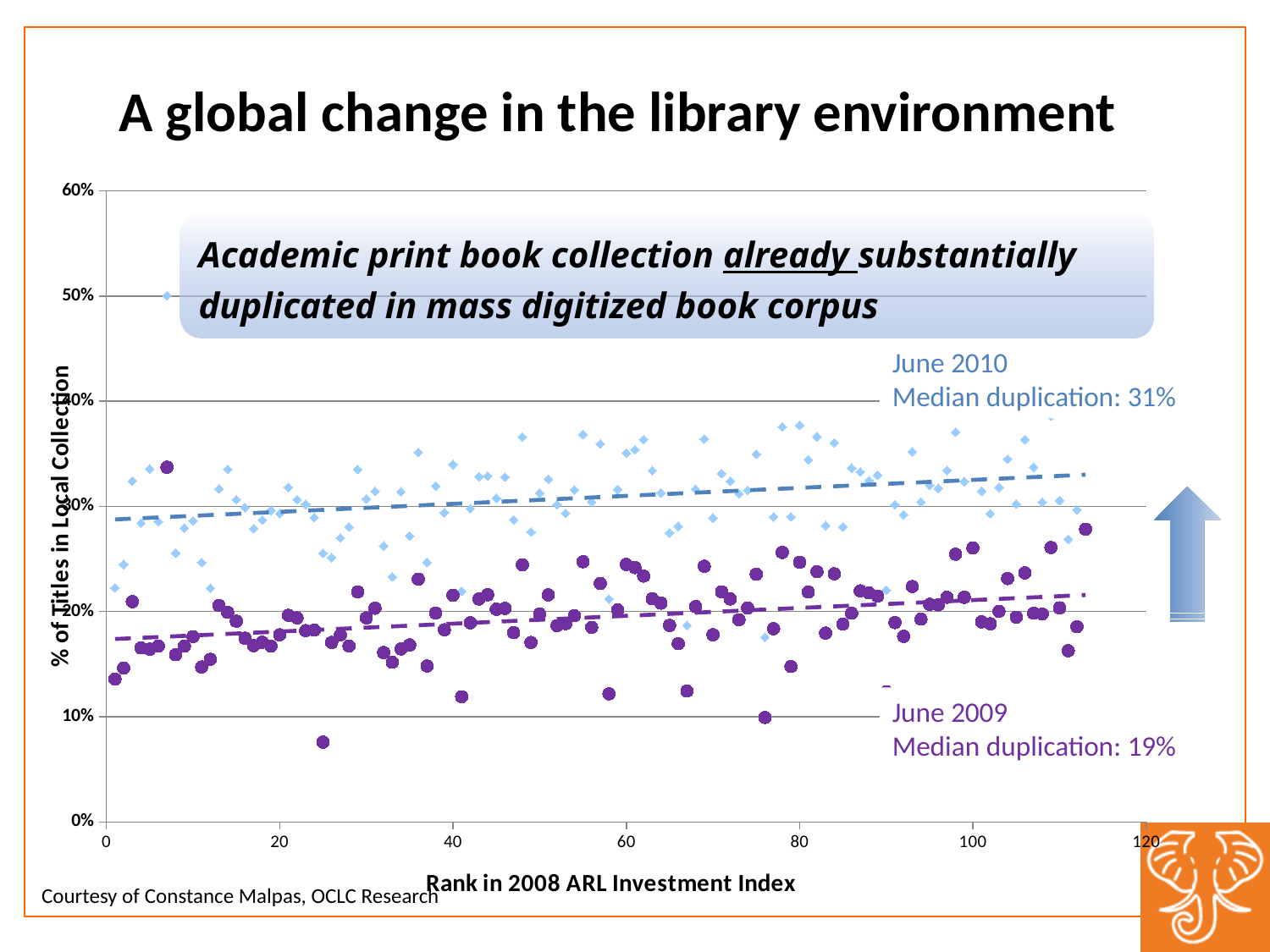
What is the difference between the June 2010 and June 2009 median duplication values? 12% What is the median duplication for June 2010 according to the chart annotation? 31% Do the dashed trend lines for both series rise or fall as rank increases along the x axis? Rise Which series has the higher median duplication, June 2010 or June 2009? June 2010 Is the highest June 2010 (blue) point greater or less than 40%? greater What is the median duplication for June 2009 according to the chart annotation? 19% Is the lowest June 2009 (purple) point greater or less than 10%? less Is the June 2009 median duplication greater or less than 20%? less What is the label of the vertical axis? % of Titles in Local Collection What kind of chart is shown on the slide? Scatter chart How many data series are plotted on the chart? 2 What is the label of the horizontal axis? Rank in 2008 ARL Investment Index